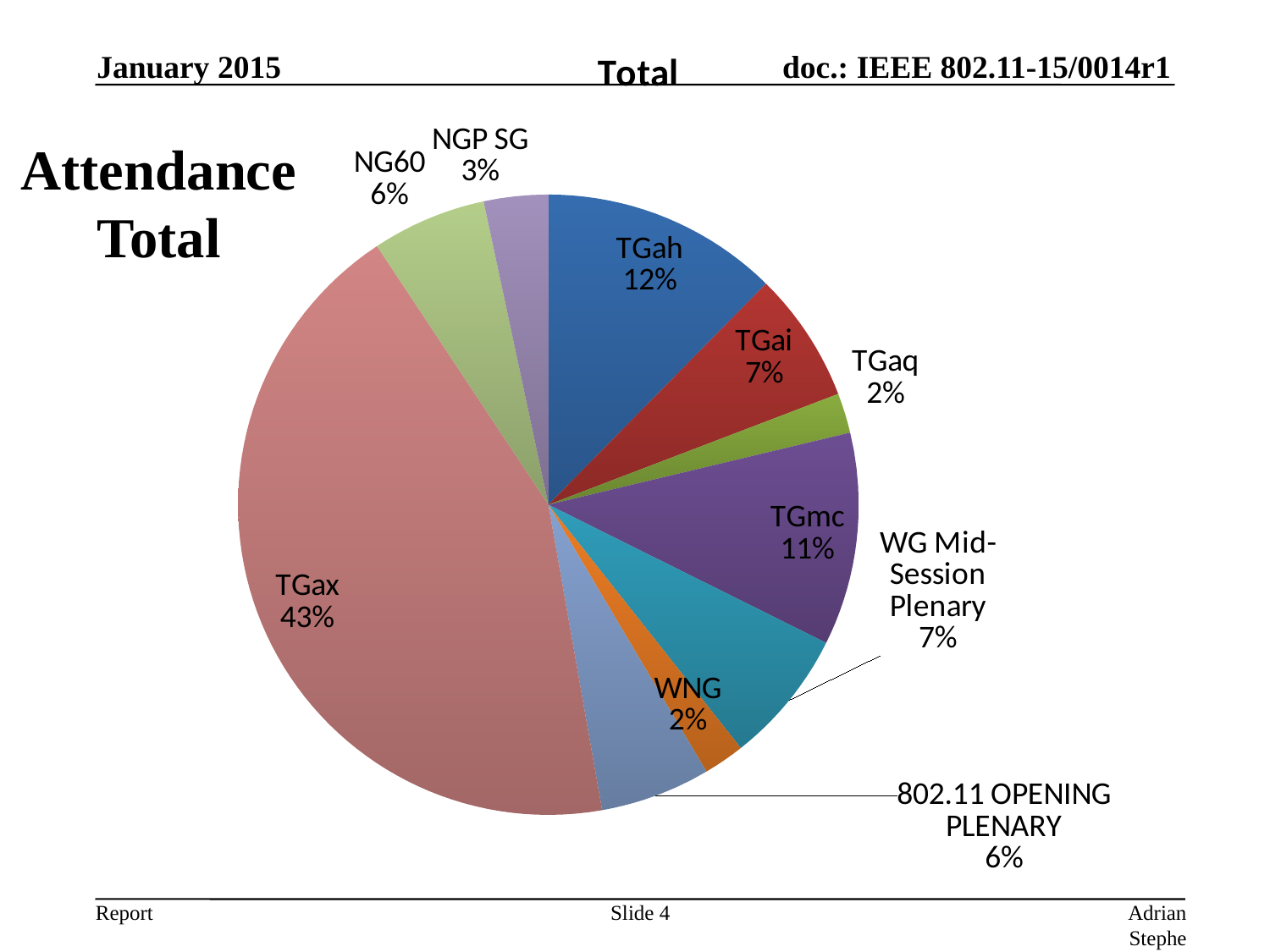
How many slices does the pie chart have? 10 What is the value shown for WG Mid-Session Plenary? 7% What share of the pie does TGax have? 43% What is the title of the chart? Total What kind of chart is shown on the slide? pie chart Which category has the largest slice of the pie? TGax What is the difference in percentage points between TGah and TGai? 5% What is the value shown for the 802.11 OPENING PLENARY slice? 6% What is the value shown for TGmc? 11% What is the value shown for NGP SG? 3% Which is larger, the slice for TGmc or the slice for NG60? TGmc What is the value shown for TGah? 12%